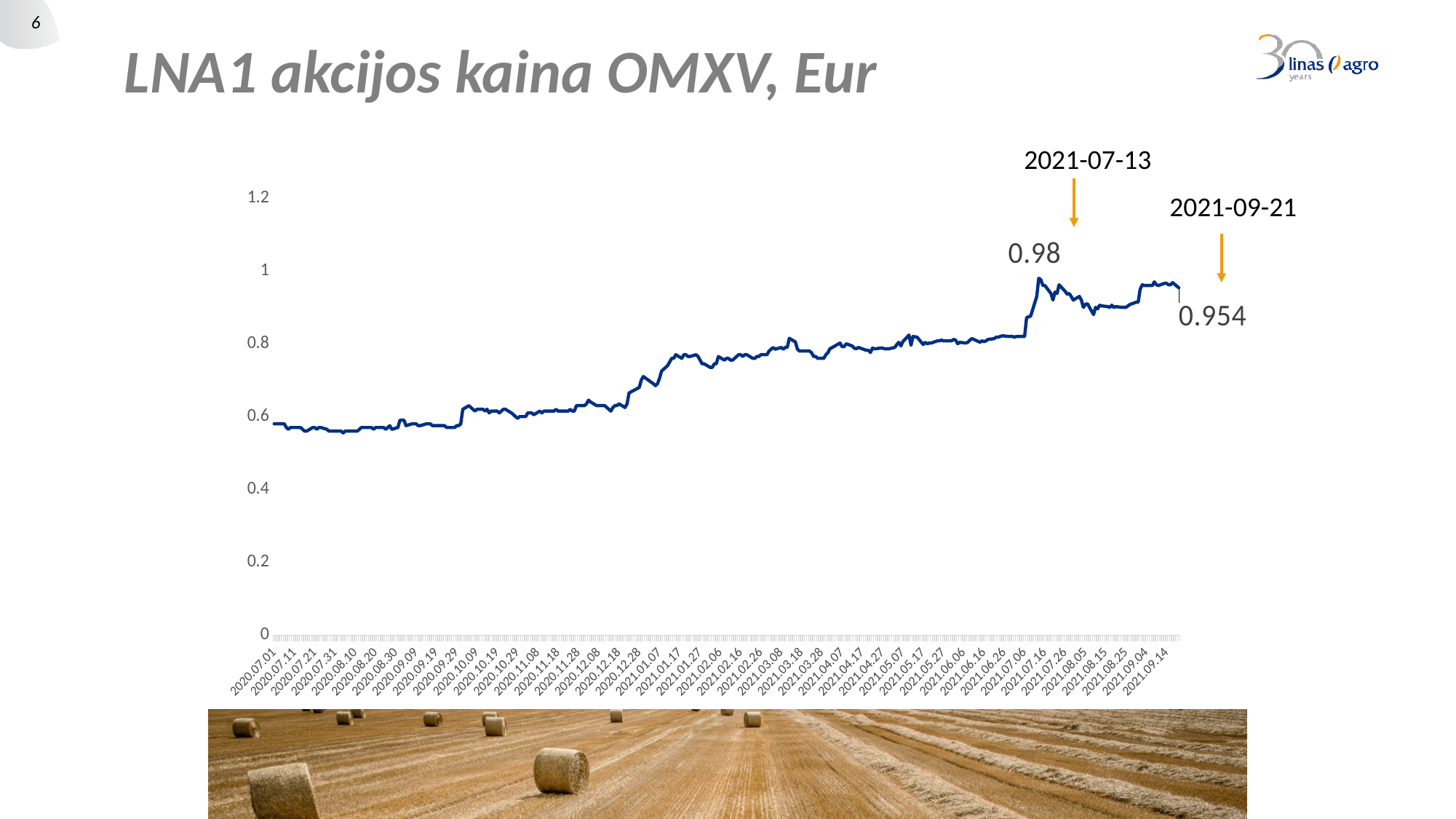
Does the share price generally rise or fall from 2020.07.01 to the end of the series? rise What is the LNA1 share price annotated for 2021-09-21? 0.954 What is the difference between the annotated price on 2021-07-13 and the annotated price on 2021-09-21? 0.026 What is the title of the slide? LNA1 akcijos kaina OMXV, Eur Is the share price around 2021.01.27 greater or less than 0.6? greater What is the LNA1 share price annotated for 2021-07-13? 0.98 What kind of chart is shown on the slide? line chart Is the share price at 2020.07.01 greater or less than 0.8? less Which annotated date has the higher share price, 2021-07-13 or 2021-09-21? 2021-07-13 How many dates are annotated with arrows and values on the chart? 2 Of the two annotated dates, which one marks the highest share price? 2021-07-13 Is the annotated share price on 2021-07-13 greater or less than 1? less